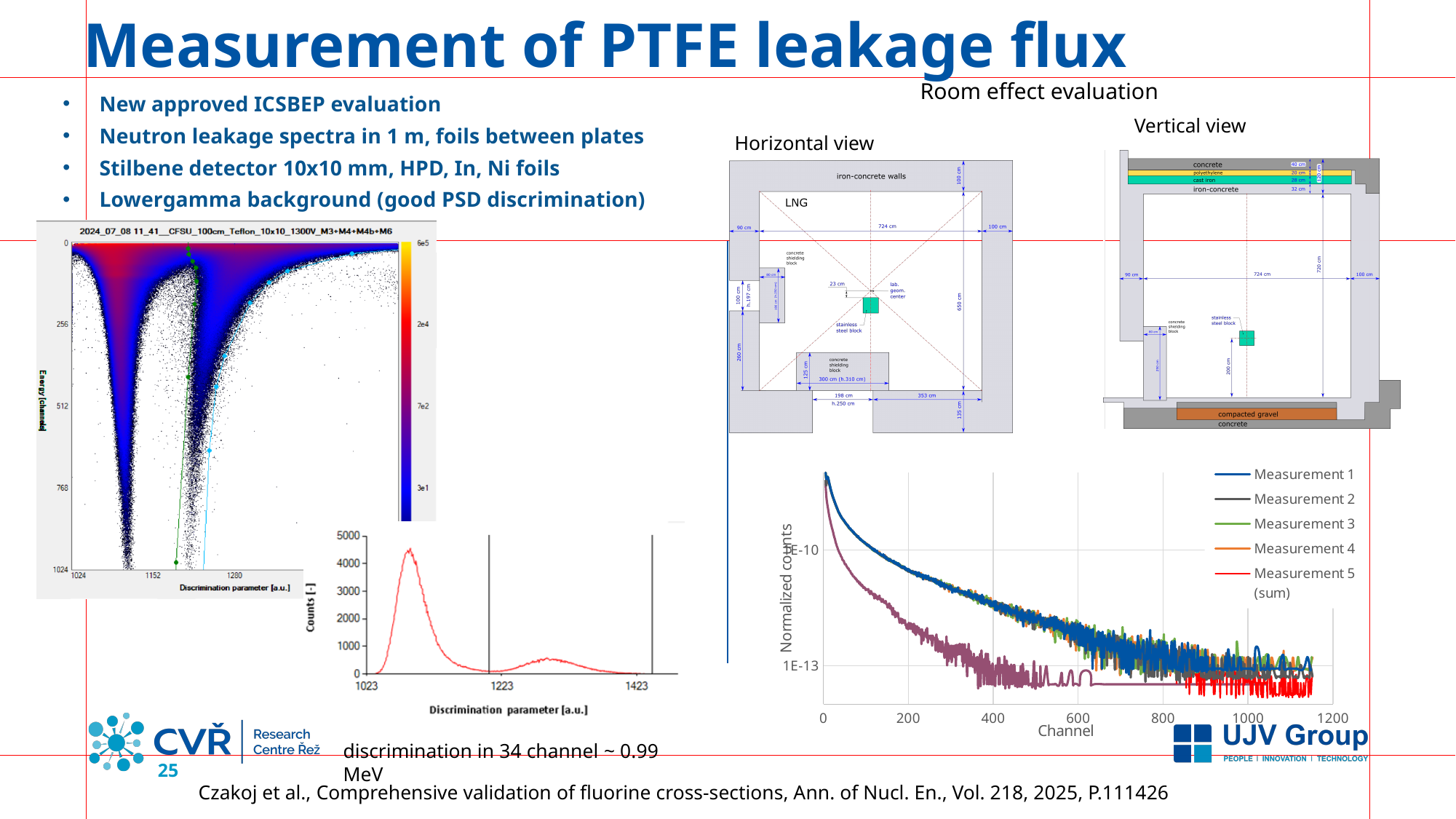
In the bottom-right chart of normalized counts versus channel, do the values rise or fall as the channel increases? fall What kind of chart is the bottom-right chart of normalized counts versus channel? line chart In the bottom-right chart of normalized counts versus channel, what is the label of the last legend entry? Measurement 5 (sum) What kind of chart is the bottom-centre chart of counts versus discrimination parameter? line chart In the bottom-right chart of normalized counts versus channel, what is the label of the x axis? Channel In the bottom-centre chart of counts versus discrimination parameter, is the peak value of the second (right) peak greater or less than 1000? less In the bottom-centre chart of counts versus discrimination parameter, which peak is higher, the left one or the right one? the left one In the top-left two-dimensional plot, what is the label of the y axis? Energy [channels] In the bottom-right chart of normalized counts versus channel, how many series does the legend list? 5 In the bottom-right chart of normalized counts versus channel, what is the highest channel value shown on the x axis? 1200 In the bottom-centre chart of counts versus discrimination parameter, what is the maximum value shown on the y axis? 5000 In the bottom-centre chart of counts versus discrimination parameter, is the peak value of the first (left) peak greater or less than 4000? greater